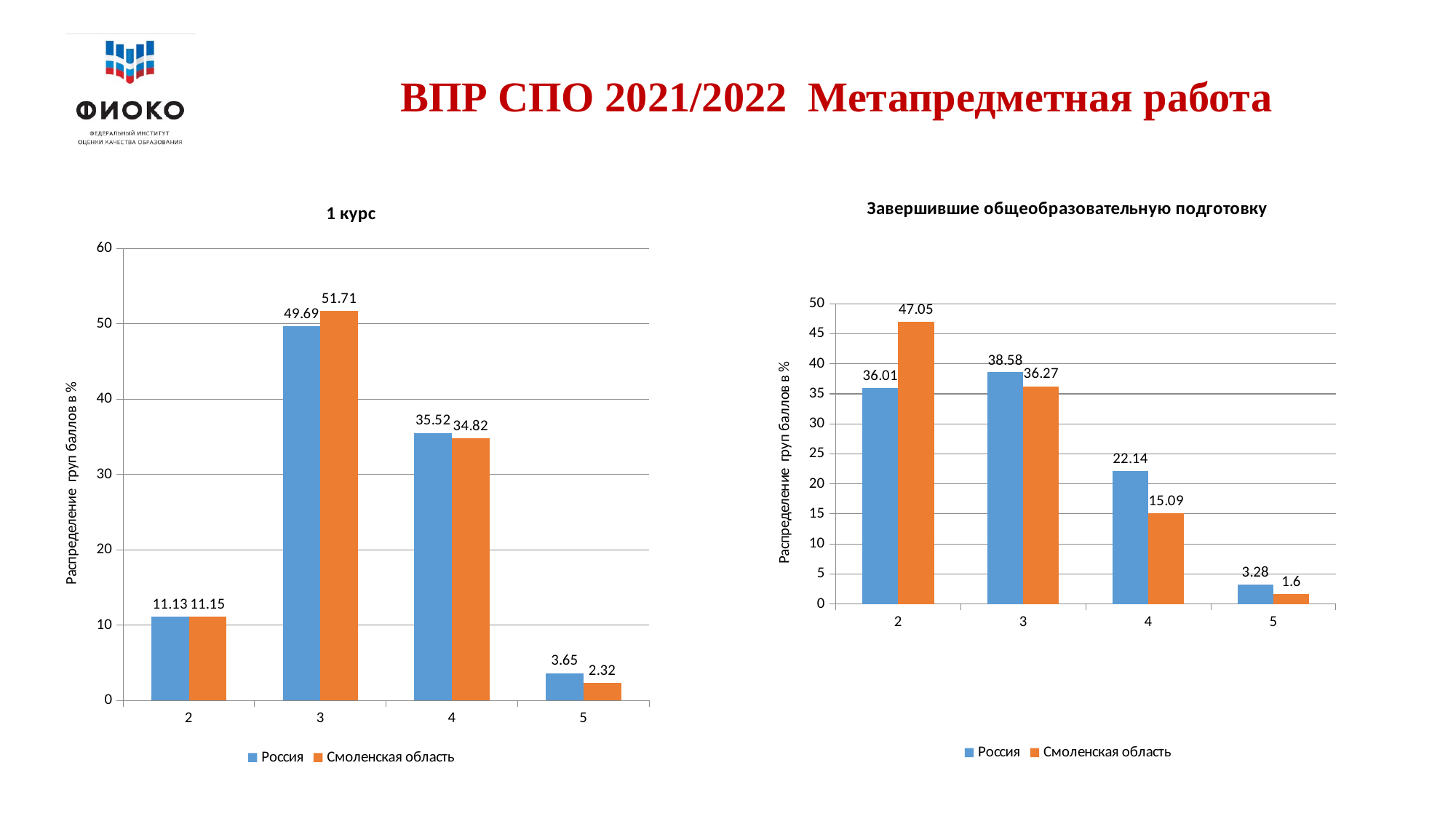
In the 'Завершившие общеобразовательную подготовку' chart, what is the value for Смоленская область at category 2? 47.05 How many categories are shown on the x axis of the '1 курс' chart? 4 In the '1 курс' chart, what is the value for Смоленская область at category 5? 2.32 In the '1 курс' chart, which category has the highest value for Смоленская область? 3 In the 'Завершившие общеобразовательную подготовку' chart, what is the difference between Россия and Смоленская область at category 4? 7.05 In the 'Завершившие общеобразовательную подготовку' chart, what is the value for Россия at category 4? 22.14 What kind of chart is the '1 курс' chart? Bar chart How many series does the legend of the 'Завершившие общеобразовательную подготовку' chart list? 2 In the 'Завершившие общеобразовательную подготовку' chart, which category has the lowest value for Россия? 5 In the '1 курс' chart, what is the value for Россия at category 3? 49.69 In the 'Завершившие общеобразовательную подготовку' chart, which is larger at category 2: Россия or Смоленская область? Смоленская область In the '1 курс' chart, which is larger at category 4: Россия or Смоленская область? Россия